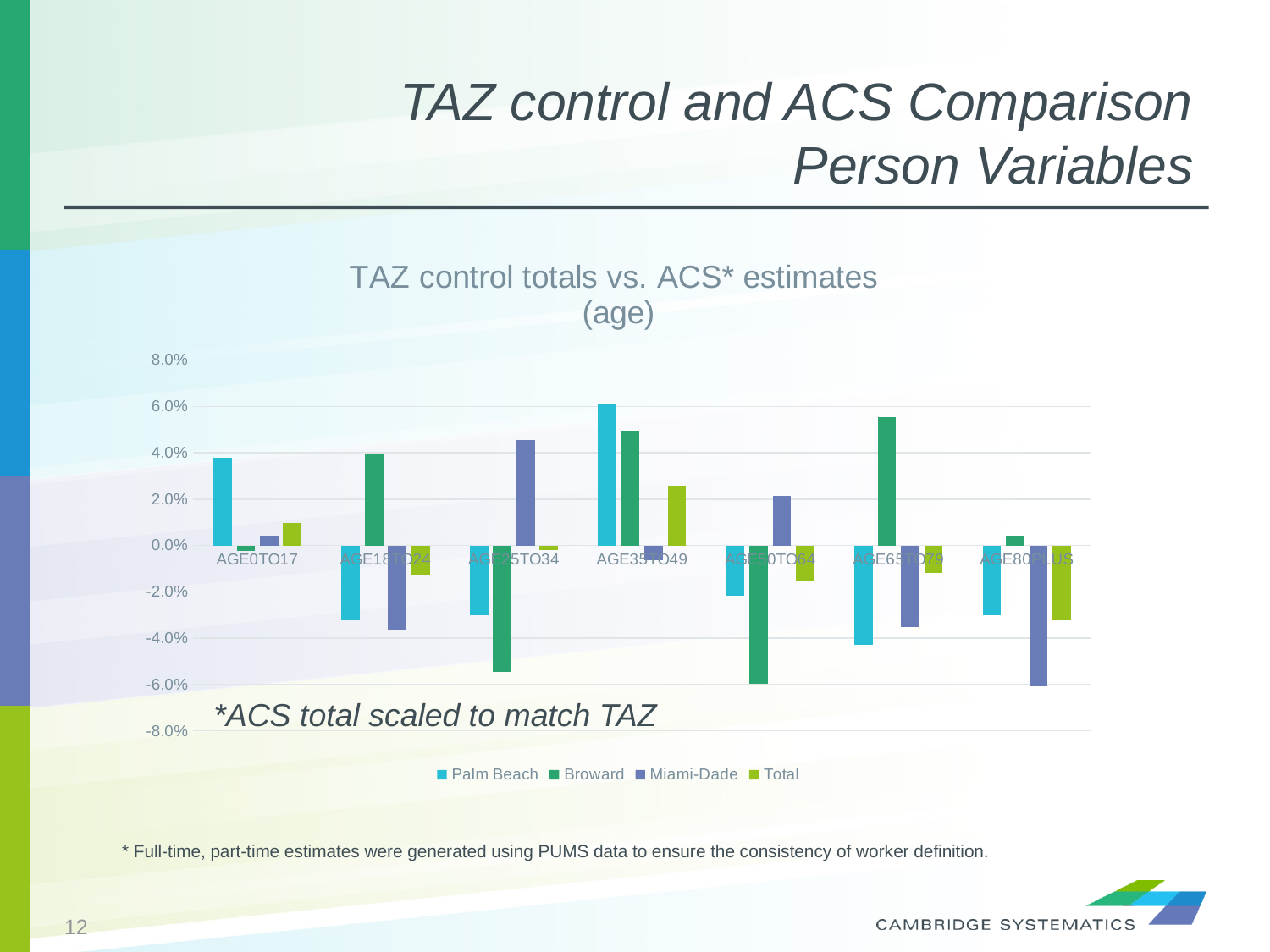
What kind of chart is shown on the slide? Bar chart For which age category is the Miami-Dade value highest? AGE25TO34 Is the Broward value for AGE25TO34 greater or less than -4.0%? less For AGE35TO49, which is larger: the Palm Beach value or the Broward value? Palm Beach For which age category is the Total value highest? AGE35TO49 How many series does the chart's legend list? 4 Is the Palm Beach value for AGE35TO49 greater or less than 4.0%? greater How many age categories are shown on the x axis of the chart? 7 What is the title of the chart? TAZ control totals vs. ACS* estimates (age) For which age category is the Miami-Dade value lowest? AGE80PLUS Which series is shown in the light blue bars? Palm Beach For which age category is the Palm Beach value highest? AGE35TO49